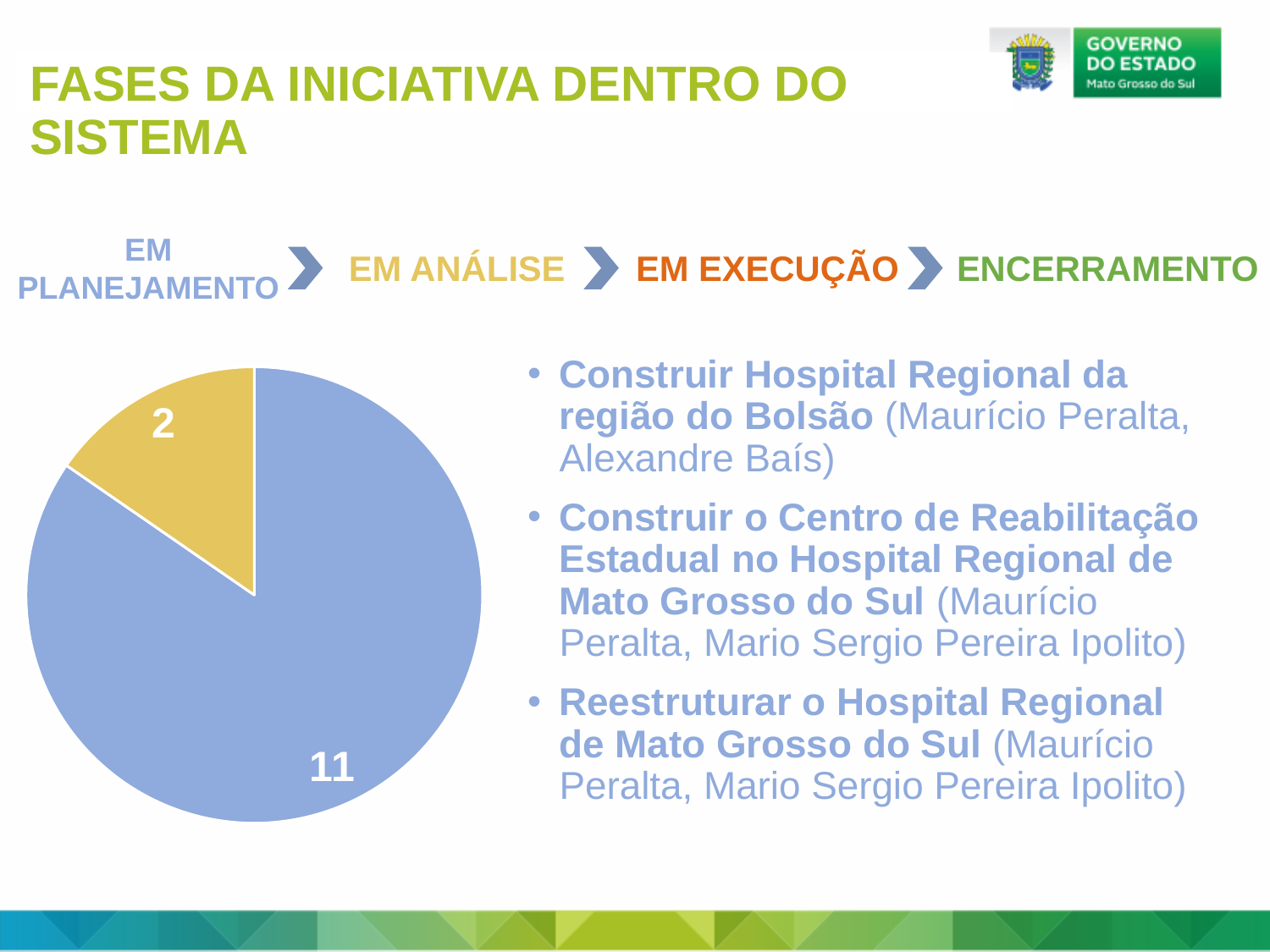
What kind of chart is shown on the left of the slide? pie chart What value is labelled on the blue slice of the pie chart? 11 How many slices does the pie chart have? 2 Which slice of the pie chart is the smallest? the yellow slice (2) Which slice of the pie chart is the largest? the blue slice (11) What is the total of the values shown in the pie chart? 13 Does the pie chart display a legend? No Which is larger in the pie chart, the blue slice or the yellow slice? the blue slice Is the value of the blue slice in the pie chart greater or less than 10? greater What value is labelled on the yellow slice of the pie chart? 2 What is the difference between the blue slice value and the yellow slice value in the pie chart? 9